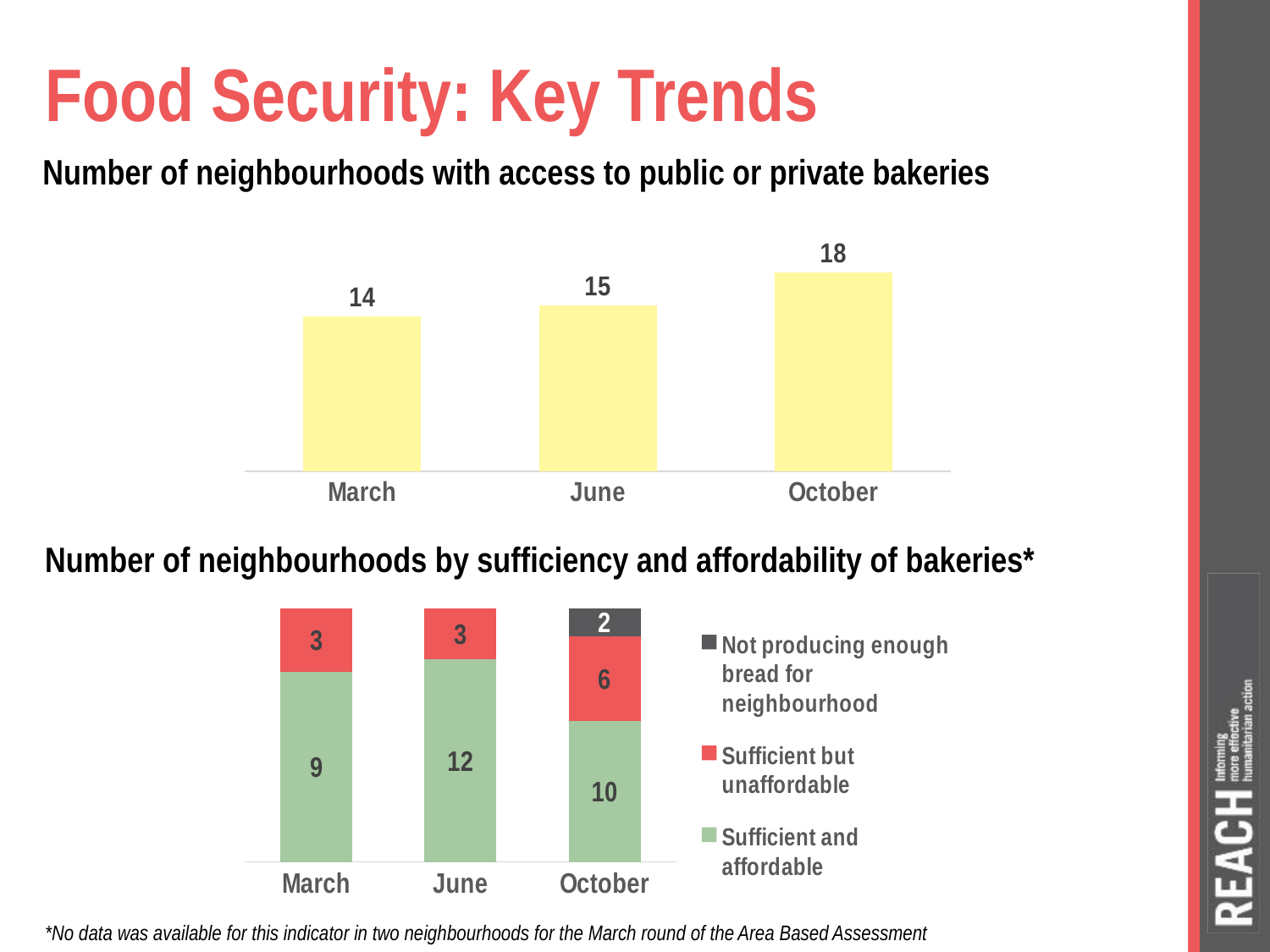
In the chart 'Number of neighbourhoods by sufficiency and affordability of bakeries*', what is the value for 'Sufficient and affordable' in June? 12 In the chart 'Number of neighbourhoods with access to public or private bakeries', how many months are shown? 3 In the chart 'Number of neighbourhoods by sufficiency and affordability of bakeries*', what is the value for 'Sufficient but unaffordable' in October? 6 In the chart 'Number of neighbourhoods with access to public or private bakeries', which month has the highest value? October In the chart 'Number of neighbourhoods with access to public or private bakeries', which month has the lowest value? March In the chart 'Number of neighbourhoods by sufficiency and affordability of bakeries*', how many series does the legend list? 3 What kind of chart is the lower chart on the slide? stacked bar chart In the chart 'Number of neighbourhoods with access to public or private bakeries', do the values rise or fall from March to October? rise In the chart 'Number of neighbourhoods by sufficiency and affordability of bakeries*', which is larger: 'Sufficient and affordable' in March or in June? June In the chart 'Number of neighbourhoods with access to public or private bakeries', what is the value for June? 15 In the chart 'Number of neighbourhoods by sufficiency and affordability of bakeries*', what is the total of the October bar? 18 In the chart 'Number of neighbourhoods with access to public or private bakeries', what is the difference between October and March? 4